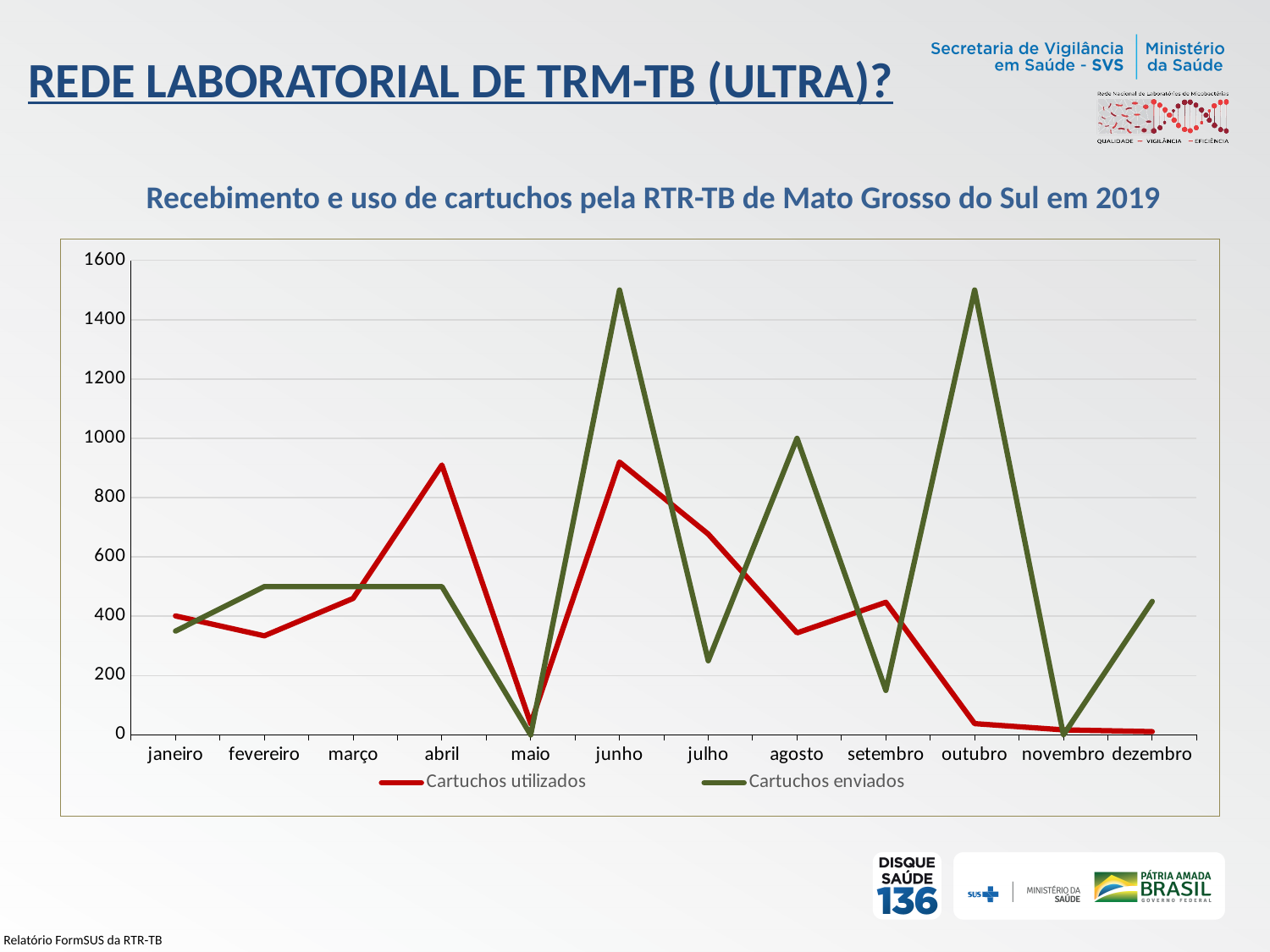
In junho, which series has the larger value, Cartuchos utilizados or Cartuchos enviados? Cartuchos enviados How many months are plotted along the x axis? 12 Does the Cartuchos utilizados line rise or fall from fevereiro to abril? Rise Is the value of Cartuchos utilizados in outubro greater or less than 200? less What is the value of Cartuchos enviados in agosto? 1000 Is the value of Cartuchos enviados in junho greater or less than 1400? greater Which colour is used for the Cartuchos enviados line? Green In abril, which series has the larger value, Cartuchos utilizados or Cartuchos enviados? Cartuchos utilizados Is the value of Cartuchos utilizados in abril greater or less than 800? greater How many series does the legend list? 2 What kind of chart is shown on the slide? Line chart What is the value of Cartuchos enviados in maio? 0